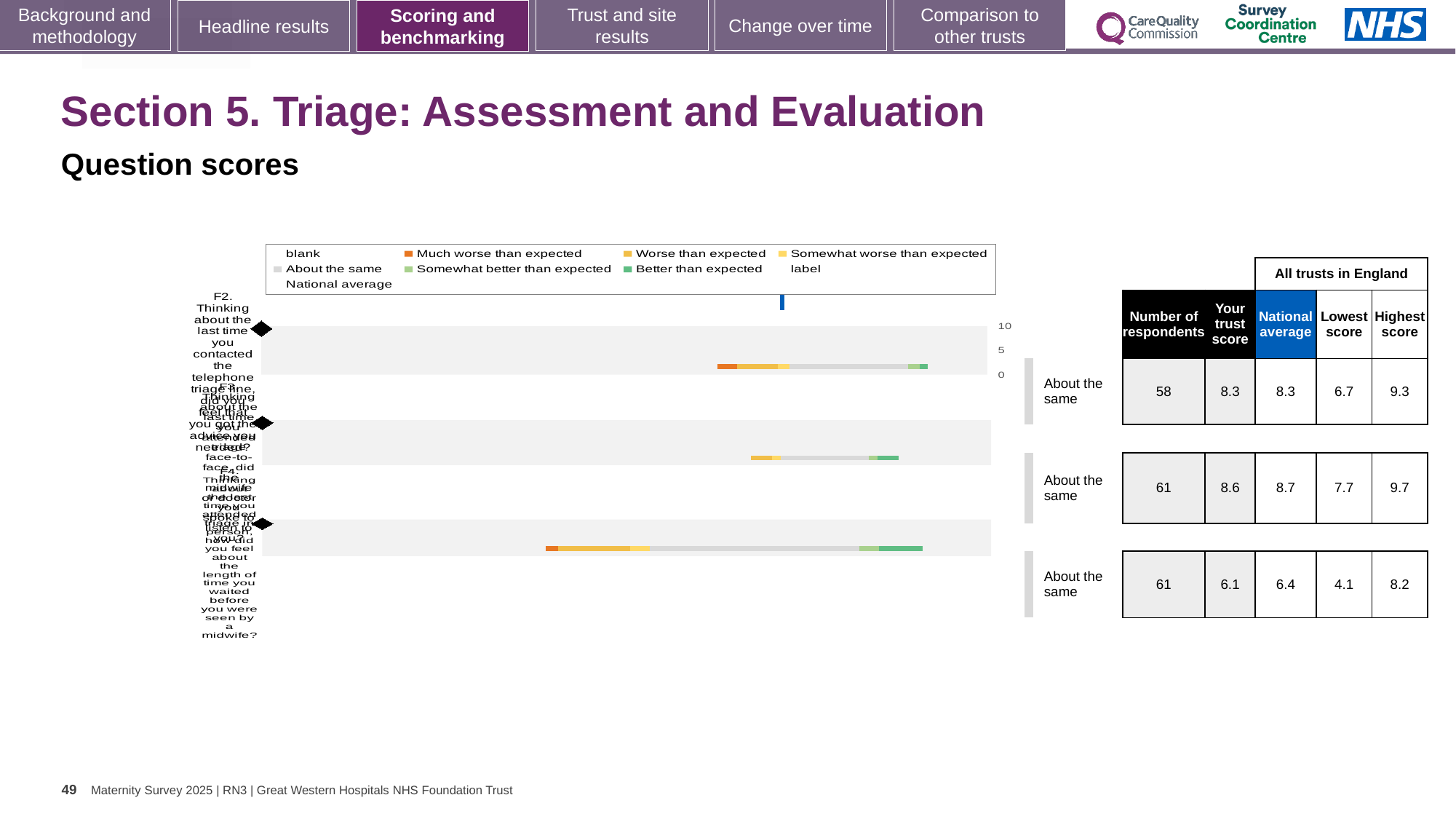
For the third question row, how much higher is the national average than the trust score? 0.3 For the third question row, what is the difference between the highest score (8.2) and the lowest score (4.1)? 4.1 Which question row has the lowest 'Lowest score' value? The third row (4.1) What is the national average for the second question row? 8.7 How many question rows are plotted in the chart? 3 Which question row has the highest 'Your trust score'? The second row (8.6) What is the highest score among all trusts in England for the second question row? 9.7 In the table beside the chart, what is the number of respondents for the first question row (F2)? 58 What is the 'Your trust score' value for the third (bottom) question row? 6.1 What benchmark label is shown next to each of the three question rows? About the same What kind of chart is shown on the slide? Bar chart For the third question row, which is larger: the trust score or the national average? The national average (6.4)